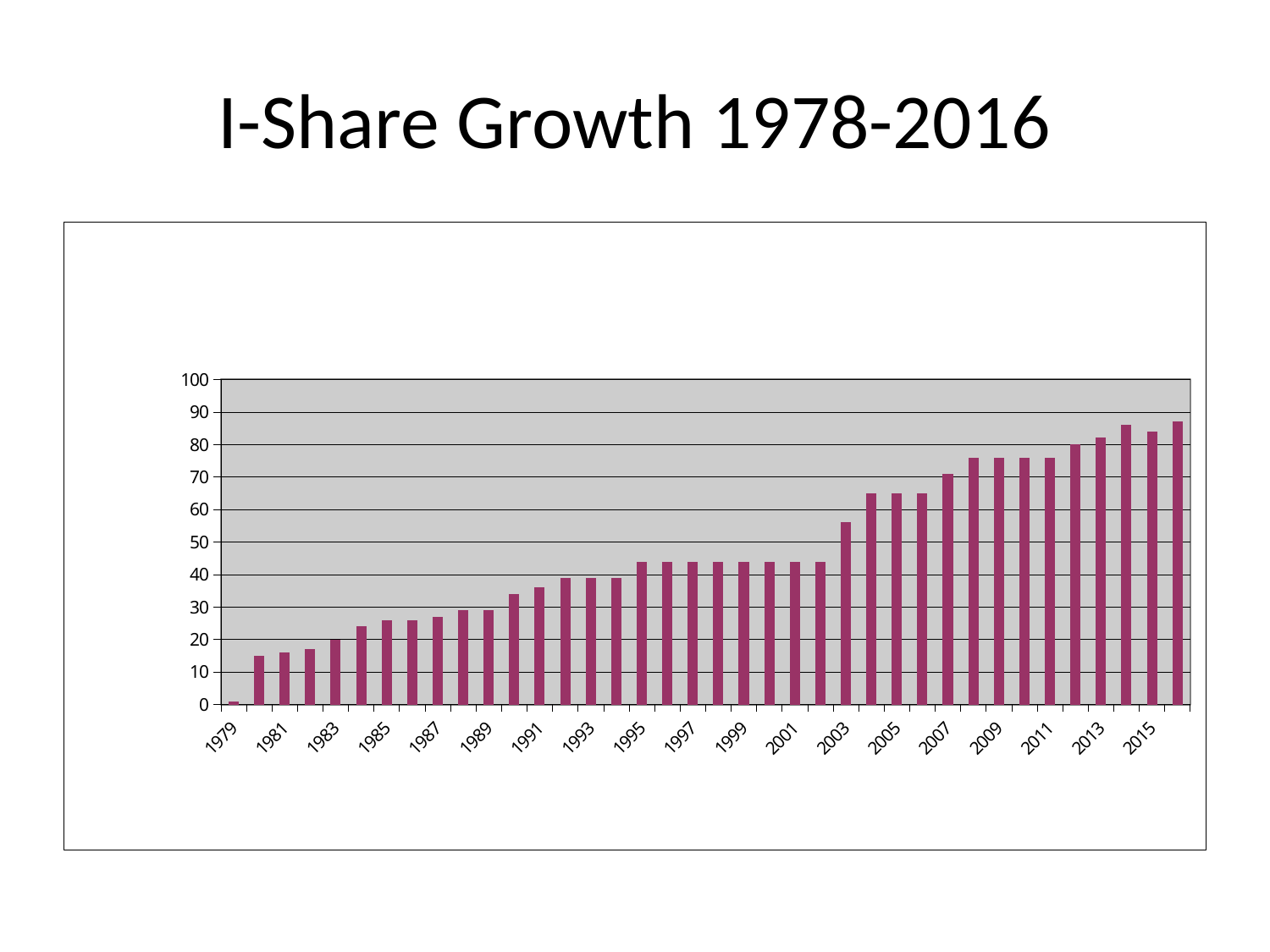
Do the values generally rise or fall from 1979 to 2016? rise Is the value for 1983 greater or less than 30? less Which is larger, the value for 1999 or the value for 2003? 2003 Which year has the lowest value in the chart? 1979 Is the value for 2003 greater or less than 50? greater Is the value for 1989 greater or less than 40? less What is the title of the slide? I-Share Growth 1978-2016 What colour are the bars in the chart? purple What kind of chart is shown on the slide? bar chart